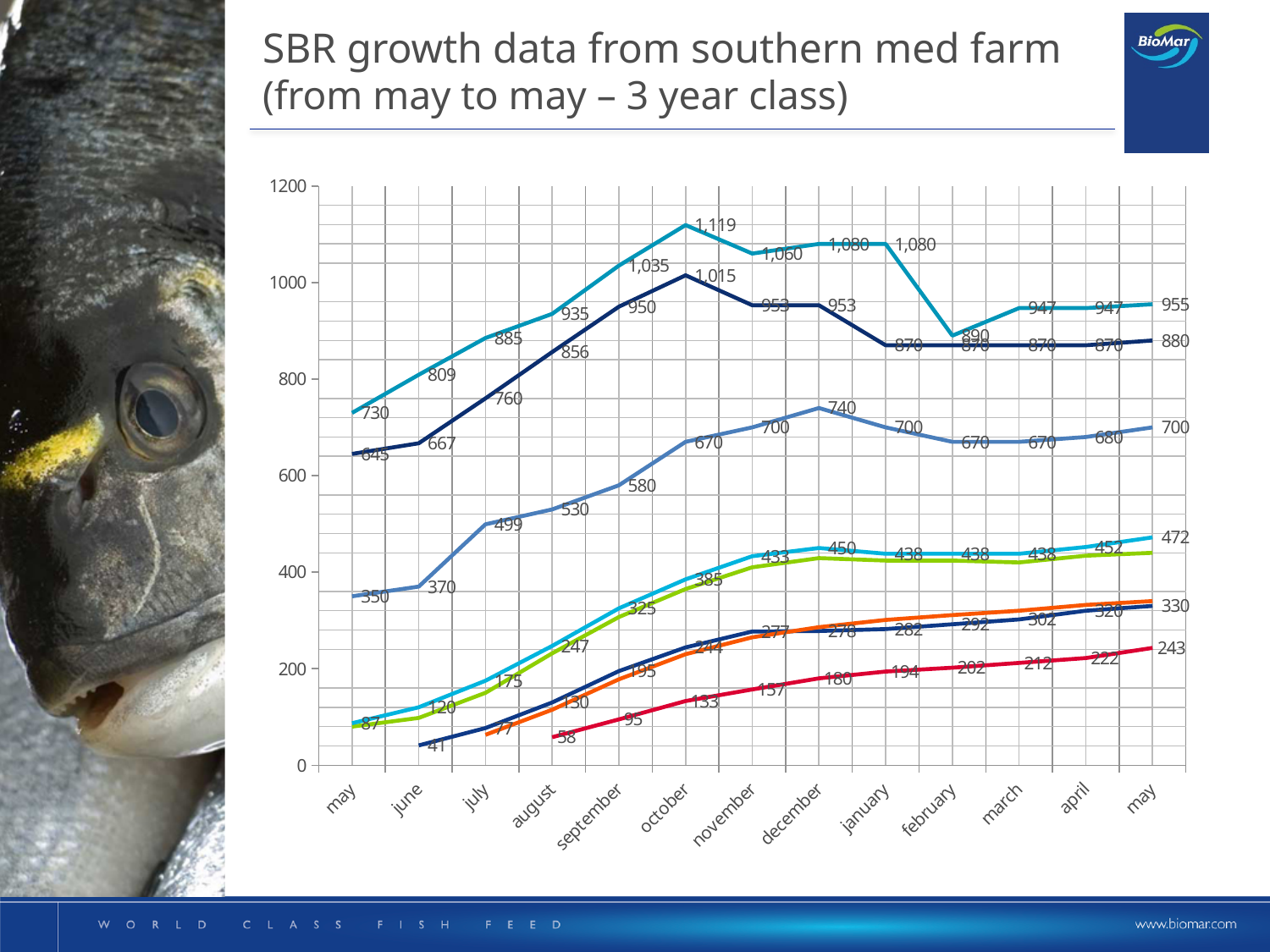
Does the lowest (red) line rise or fall from august to the final may? rises What is the peak value of the dark navy line that starts at 645 in may? 1,015 What is the value of the top (teal) line in the final may? 955 What is the first value shown for the lowest (red) line, in august? 58 What kind of chart is shown on the slide? line chart What is the value of the medium blue line (starting at 350) in december? 740 What is the value of the lowest (red) line in the final may? 243 What is the value of the top (teal) line in the first month, may? 730 What is the highest value reached by the top (teal) line, and in which month? 1,119 in october Is the value of the top (teal) line in february greater or less than 1000? less By how much does the top (teal) line drop from october (1,119) to november (1,060)? 59 How many months are shown along the x axis of the chart? 13